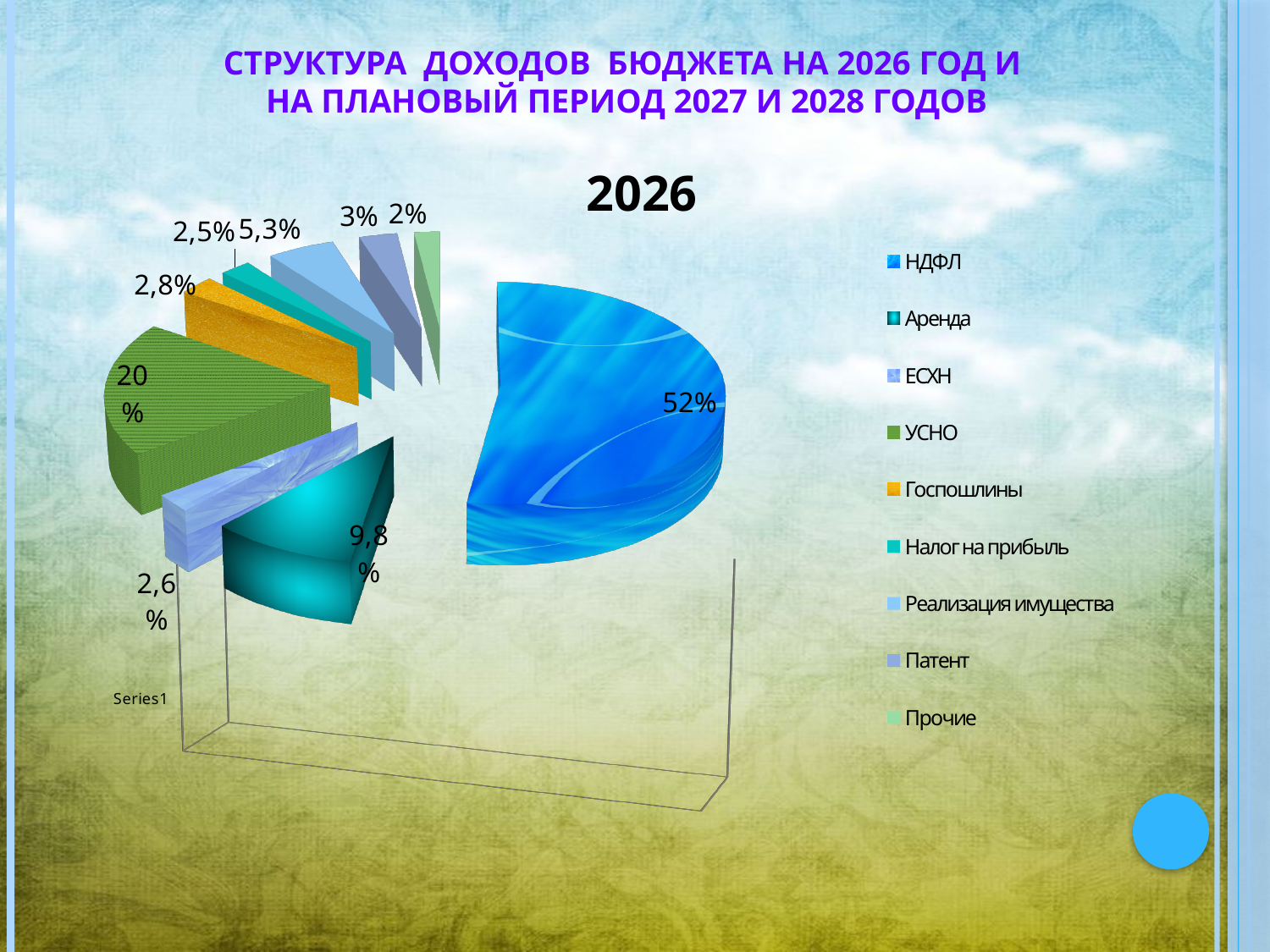
How many categories does the legend of the 2026 pie chart list? 9 What is the share of Аренда in the 2026 pie chart? 9,8% Which category has the smallest slice in the 2026 pie chart? Прочие What is the share of Госпошлины in the 2026 pie chart? 2,8% What is the difference between the shares of НДФЛ and УСНО in the 2026 pie chart? 32% Which is larger in the 2026 pie chart, УСНО or Аренда? УСНО What is the share of Реализация имущества in the 2026 pie chart? 5,3% Which category has the largest slice in the 2026 pie chart? НДФЛ What is the title shown above the pie chart? 2026 What is the share of УСНО in the 2026 pie chart? 20% What is the share of НДФЛ in the 2026 pie chart? 52% What kind of chart is shown on the slide? pie chart